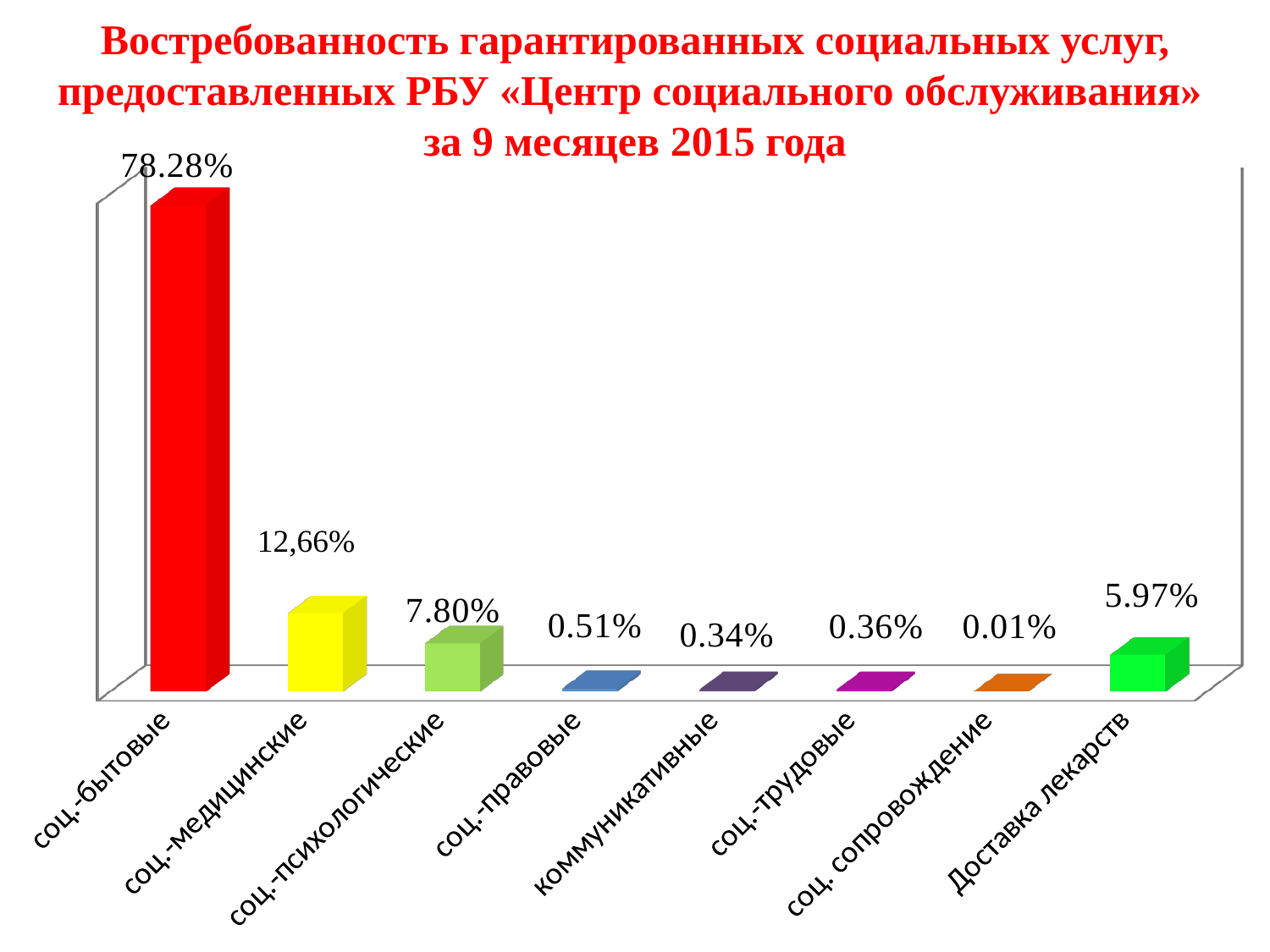
What is the value for Доставка лекарств? 5.97% Which category has the highest value? соц.-бытовые What is the value for соц.-бытовые? 78.28% What is the value for соц. сопровождение? 0.01% What is the difference between the values for соц.-психологические and Доставка лекарств? 1.83% Which is larger, the value for соц.-психологические or the value for Доставка лекарств? соц.-психологические What kind of chart is shown on the slide? bar chart What is the value for соц.-медицинские? 12,66% What colour is the bar for соц.-бытовые? red What is the difference between the values for соц.-бытовые and соц.-медицинские? 65.62% How many categories are shown in the chart? 8 Which category has the lowest value? соц. сопровождение